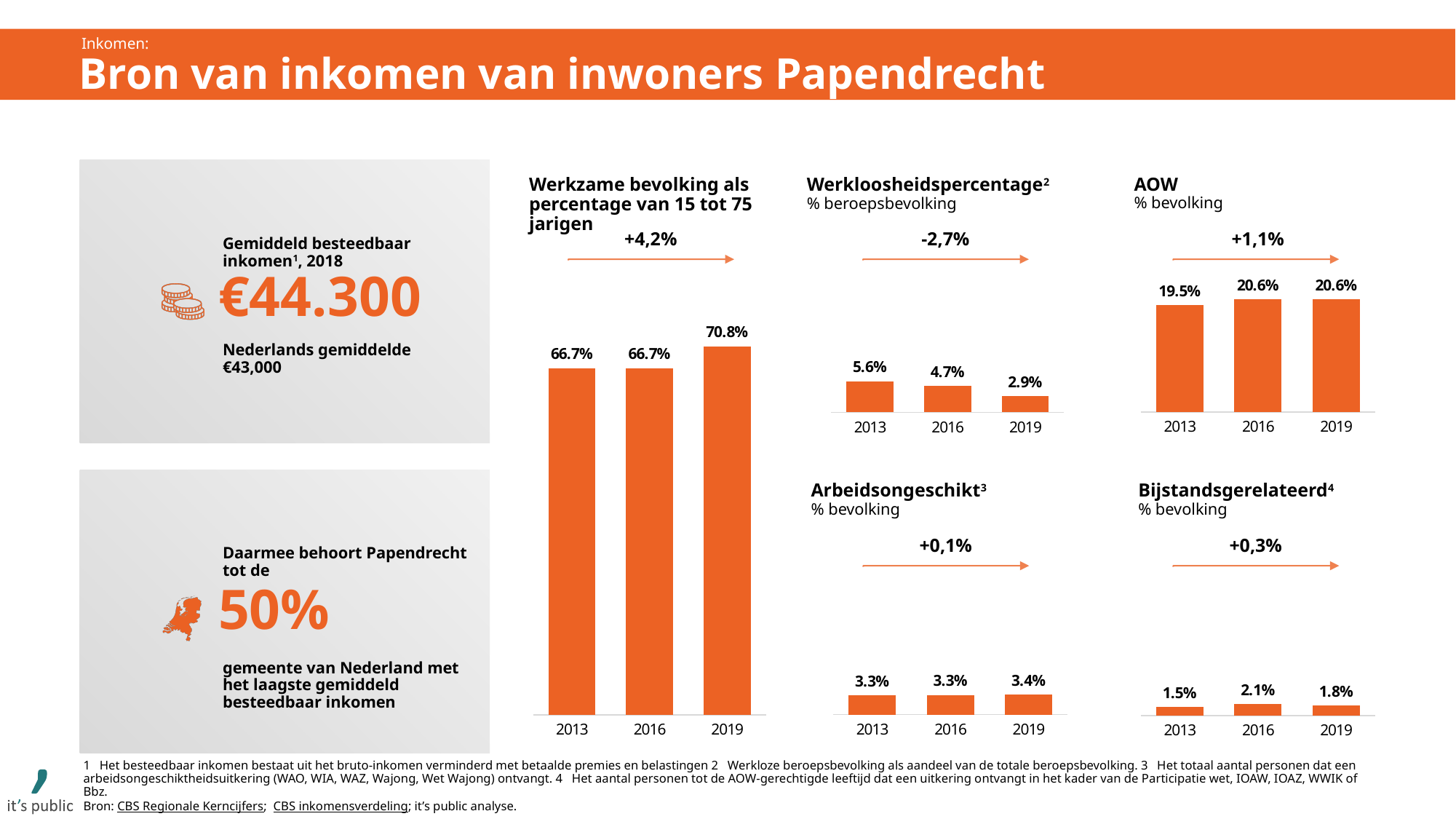
In the 'Werkloosheidspercentage' chart, do the values rise or fall from 2013 to 2019? fall How many years are shown in the 'AOW' chart? 3 What change is shown by the arrow above the 'AOW' chart? +1,1% In the 'Werkzame bevolking als percentage van 15 tot 75 jarigen' chart, what is the value for 2019? 70.8% In the 'Bijstandsgerelateerd' chart, which year has the highest value? 2016 In the 'Arbeidsongeschikt' chart, is the value for 2019 larger or smaller than the value for 2013? larger In the 'Bijstandsgerelateerd' chart, what is the difference between the 2016 and 2013 values? 0.6% What kind of chart is the 'Arbeidsongeschikt' chart? bar chart In the 'Werkloosheidspercentage' chart, which year has the lowest value? 2019 In the 'Werkloosheidspercentage' chart, what is the difference between the 2013 and 2019 values? 2.7% In the 'Werkloosheidspercentage' chart, what is the value for 2013? 5.6% In the 'AOW' chart, what is the value for 2016? 20.6%